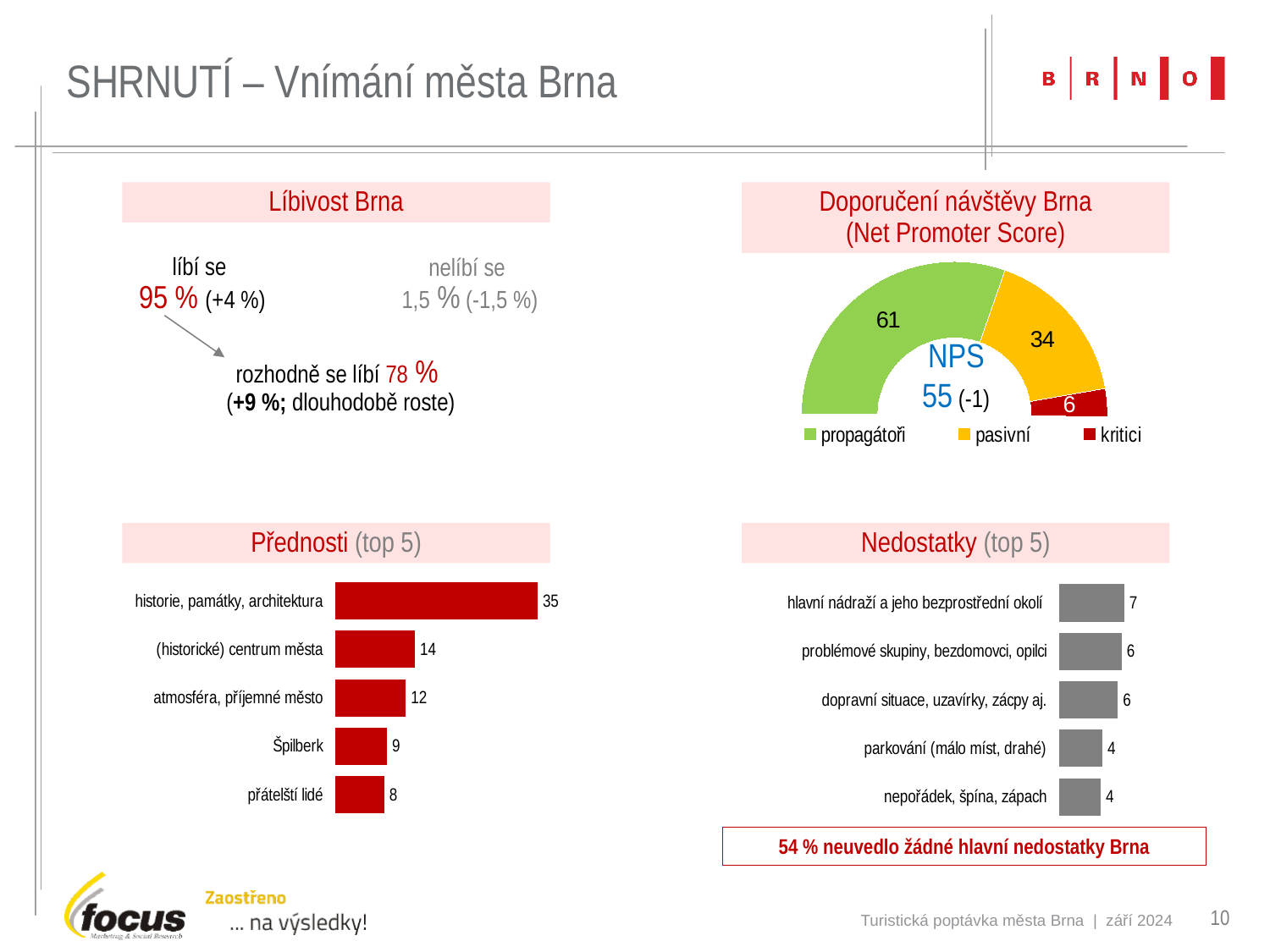
In the 'Doporučení návštěvy Brna (Net Promoter Score)' chart, what is the value for 'kritici'? 6 How many entries does the legend of the 'Doporučení návštěvy Brna (Net Promoter Score)' chart list? 3 In the 'Nedostatky (top 5)' chart, what is the value for 'parkování (málo míst, drahé)'? 4 In the 'Přednosti (top 5)' chart, which category has the lowest value? přátelští lidé In the 'Přednosti (top 5)' chart, what is the value for 'historie, památky, architektura'? 35 What kind of chart is the 'Nedostatky (top 5)' chart? bar chart In the 'Přednosti (top 5)' chart, how many categories are shown? 5 In the 'Nedostatky (top 5)' chart, which category has the highest value? hlavní nádraží a jeho bezprostřední okolí In the 'Nedostatky (top 5)' chart, what is the value for 'hlavní nádraží a jeho bezprostřední okolí'? 7 In the 'Přednosti (top 5)' chart, which is larger: 'atmosféra, příjemné město' or 'Špilberk'? atmosféra, příjemné město In the 'Doporučení návštěvy Brna (Net Promoter Score)' chart, what is the value for 'propagátoři'? 61 In the 'Přednosti (top 5)' chart, what is the difference between 'historie, památky, architektura' and '(historické) centrum města'? 21